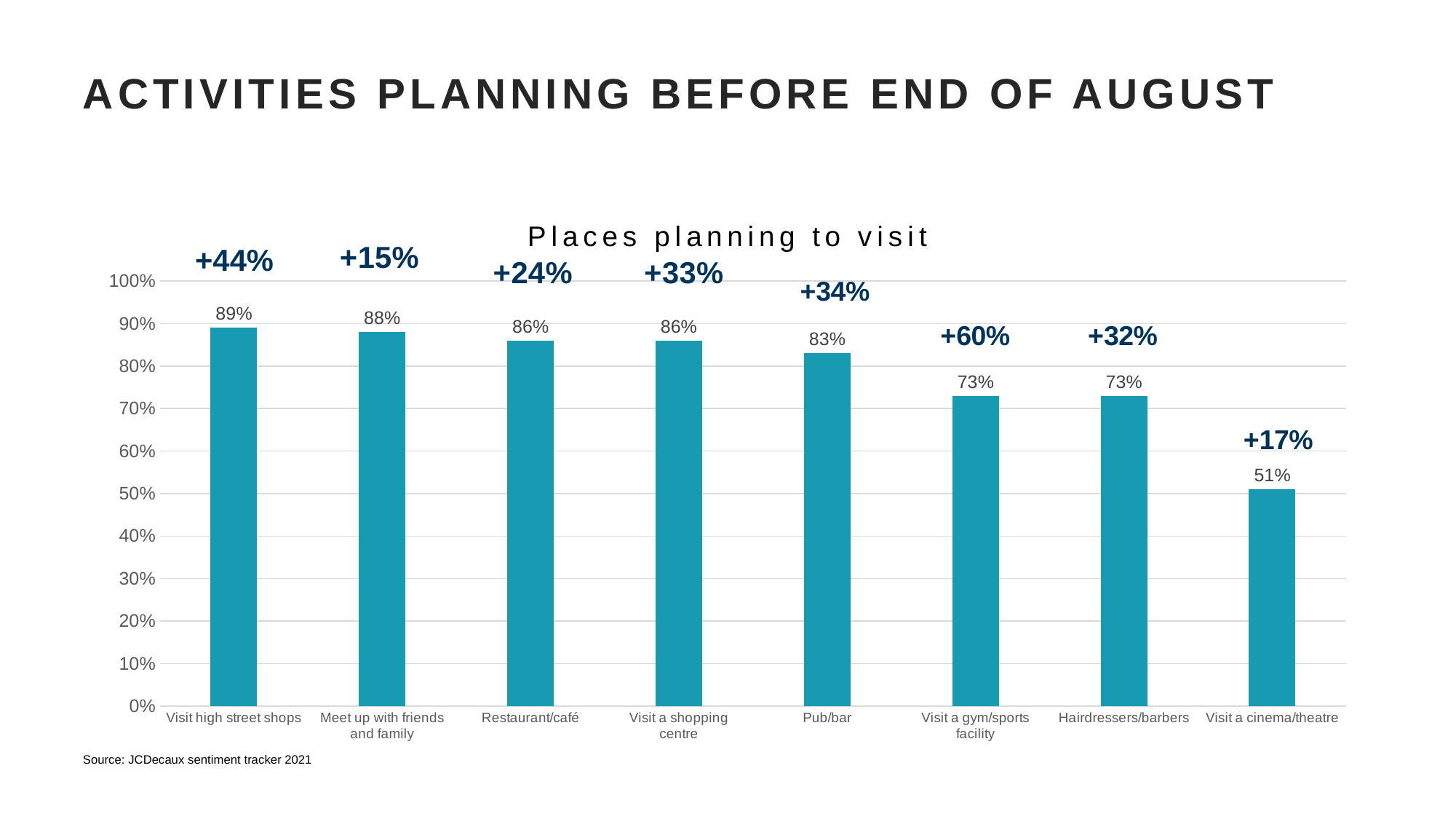
What is the difference between the values for Pub/bar and Visit a gym/sports facility? 10% Which category has the lowest value? Visit a cinema/theatre What is the difference between the values for Visit high street shops and Visit a cinema/theatre? 38% What is the title of the chart? Places planning to visit What is the value for Hairdressers/barbers? 73% Which category has the highest value? Visit high street shops What kind of chart is shown on the slide? Bar chart Which is larger, the value for Pub/bar or the value for Hairdressers/barbers? Pub/bar What is the value for Visit a cinema/theatre? 51% What is the value for Pub/bar? 83% What is the value for Visit high street shops? 89% How many categories are shown on the x axis? 8